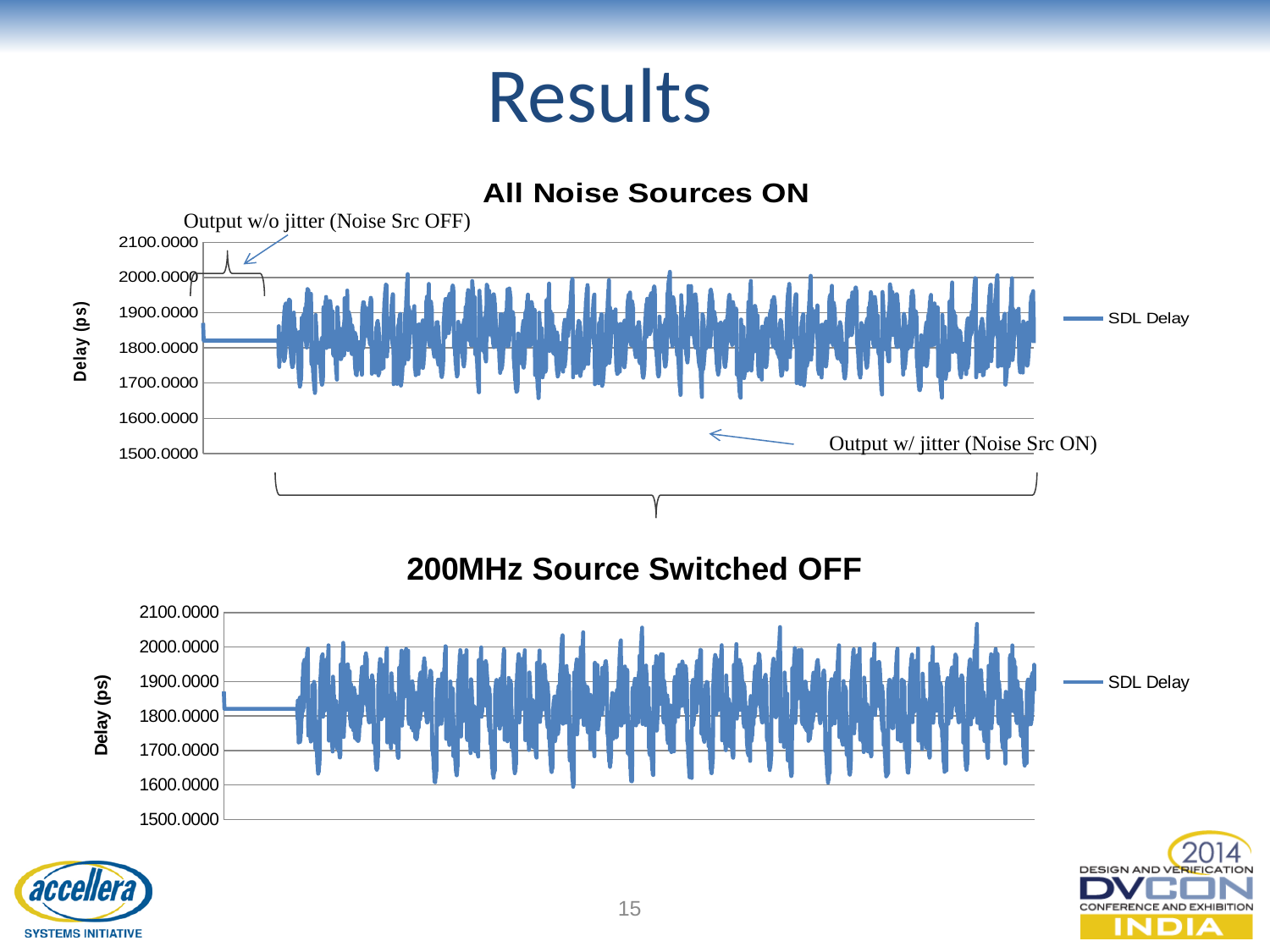
In the 'All Noise Sources ON' chart, is the lowest dip of the SDL Delay trace greater or less than 1700? less What is the title of the lower chart on the slide? 200MHz Source Switched OFF What kind of chart is the 'All Noise Sources ON' chart? line chart In the 'All Noise Sources ON' chart, is the lowest dip of the SDL Delay trace greater or less than 1600? greater What kind of chart is the '200MHz Source Switched OFF' chart? line chart How many series does the legend of the 'All Noise Sources ON' chart list? 1 In the '200MHz Source Switched OFF' chart, is the highest peak of the SDL Delay trace greater or less than 2000? greater What is the name of the series shown in the legend of the 'All Noise Sources ON' chart? SDL Delay How many series does the legend of the '200MHz Source Switched OFF' chart list? 1